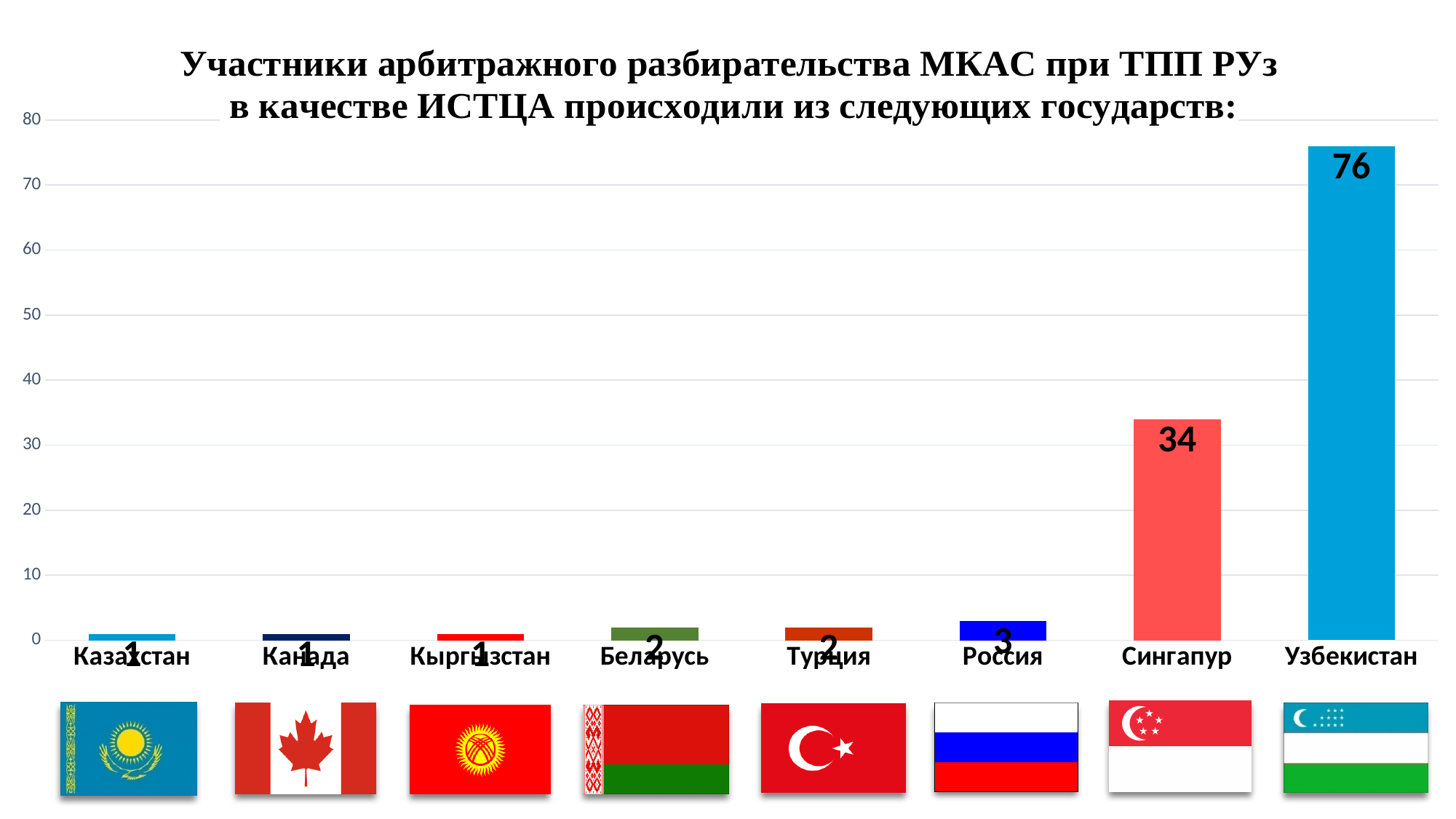
What kind of chart is shown on the slide? bar chart What is the value for Узбекистан? 76 Is the value for Узбекистан greater or less than 70? greater Which is larger, the value for Сингапур or the value for Россия? Сингапур What is the value for Беларусь? 2 What is the value for Сингапур? 34 What is the difference between the values for Узбекистан and Сингапур? 42 What is the value for Россия? 3 How many countries are shown on the chart? 8 Which country has the highest value? Узбекистан What is the difference between the values for Россия and Турция? 1 Do the values rise or fall from left to right along the x axis? rise